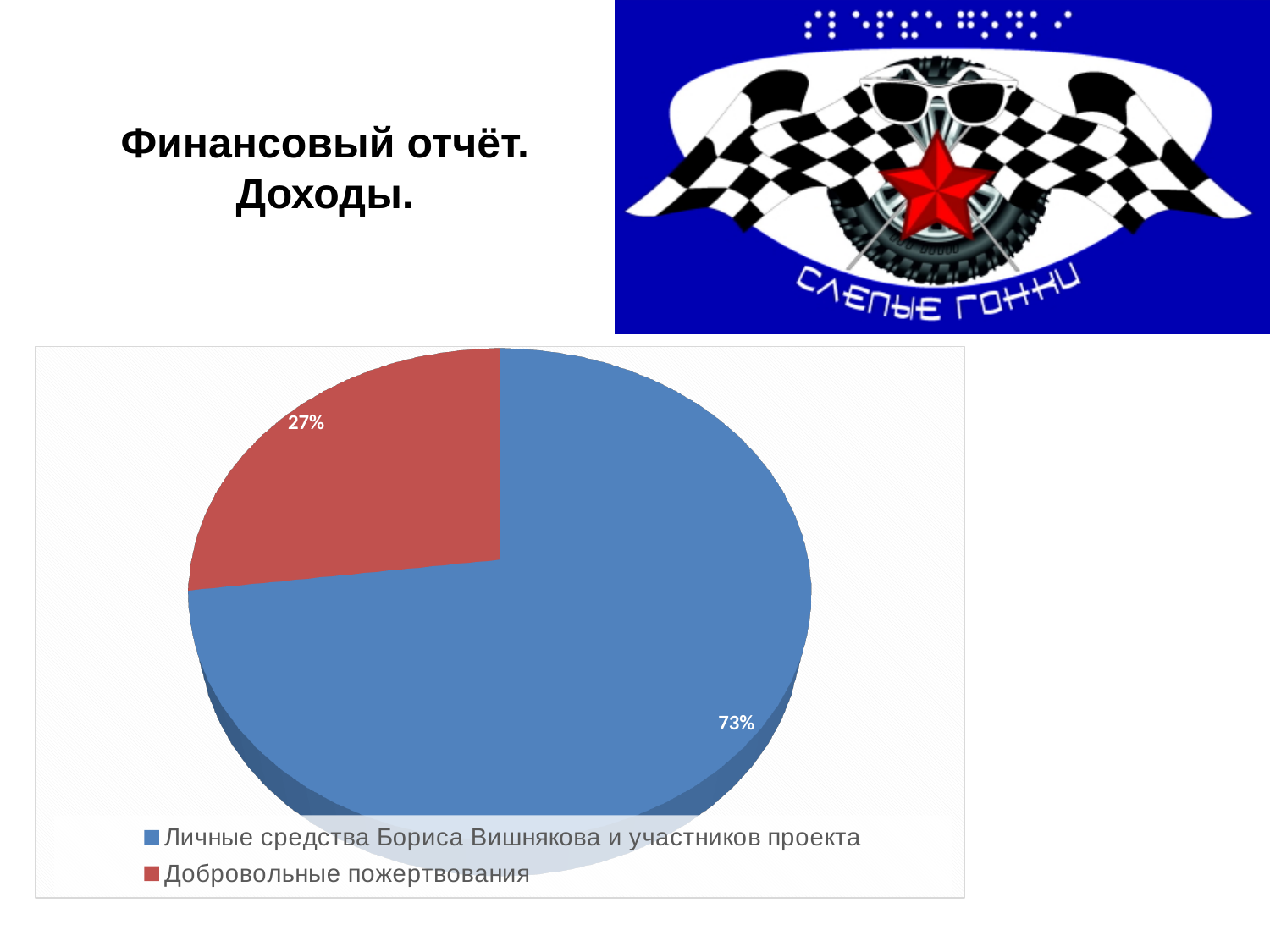
What is the difference in percentage points between the two slices of the pie? 46 Which category has the smallest slice of the pie? Добровольные пожертвования What share of the pie does "Личные средства Бориса Вишнякова и участников проекта" represent? 73% How many entries does the legend list? 2 What share of the pie does "Добровольные пожертвования" represent? 27% What is the title of the slide containing the pie chart? Финансовый отчёт. Доходы. How many categories does the pie chart show? 2 Which category has the largest slice of the pie? Личные средства Бориса Вишнякова и участников проекта What kind of chart is shown on the slide? pie chart What colour is the slice for "Добровольные пожертвования"? red Which is larger: the slice for "Добровольные пожертвования" or the slice for "Личные средства Бориса Вишнякова и участников проекта"? Личные средства Бориса Вишнякова и участников проекта